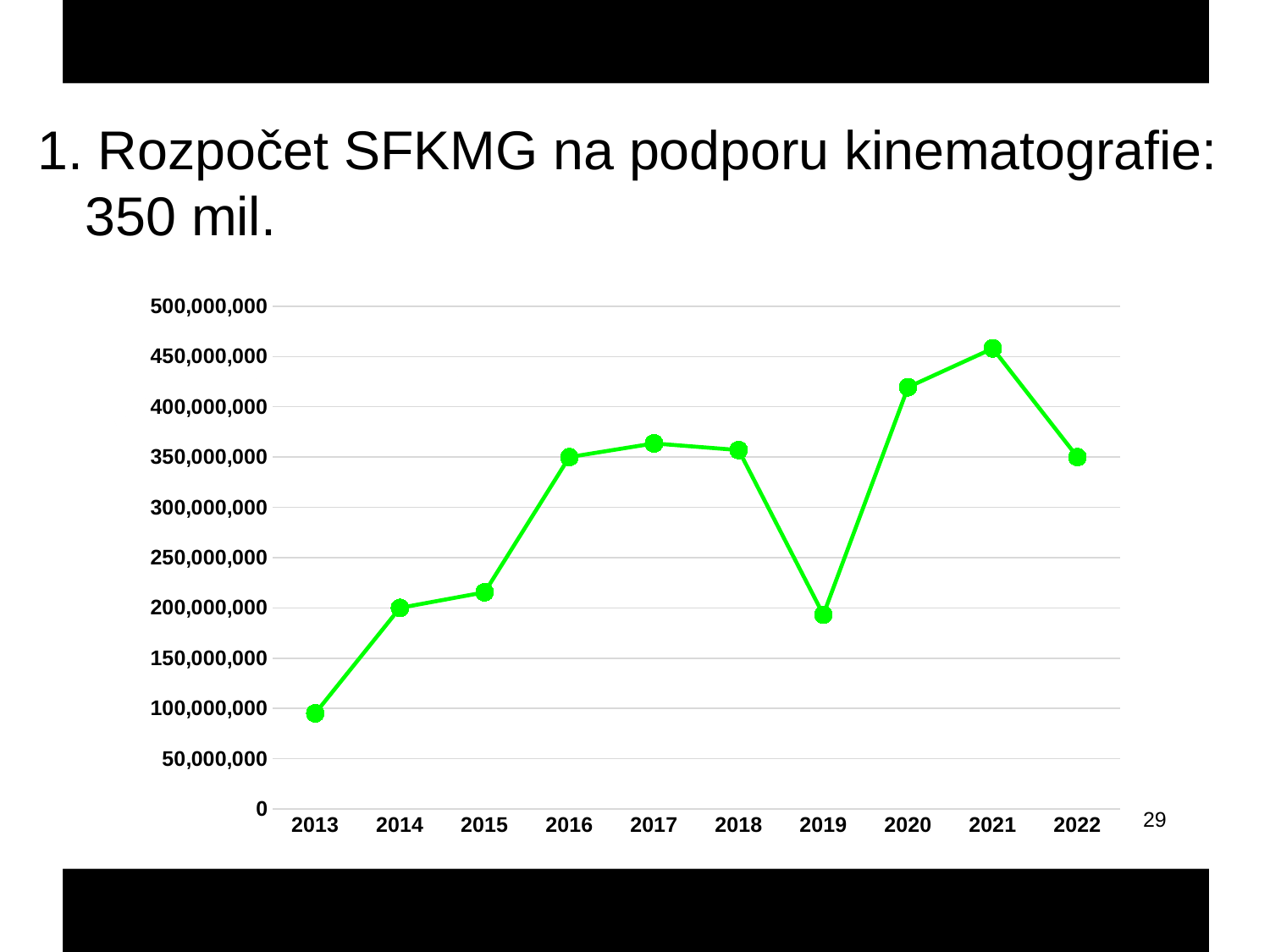
Is the value for 2020 greater or less than 400,000,000? greater How many years are plotted on the x axis of the chart? 10 What kind of chart is shown on the slide? line chart Is the value for 2017 greater or less than 300,000,000? greater Is the value for 2013 greater or less than 150,000,000? less Which year has the lowest value in the chart? 2013 Do the values rise or fall from 2021 to 2022? fall Do the values rise or fall from 2013 to 2016? rise Which year has the larger value, 2019 or 2020? 2020 Which year has the highest value in the chart? 2021 What is the value for 2022 in the chart? 350,000,000